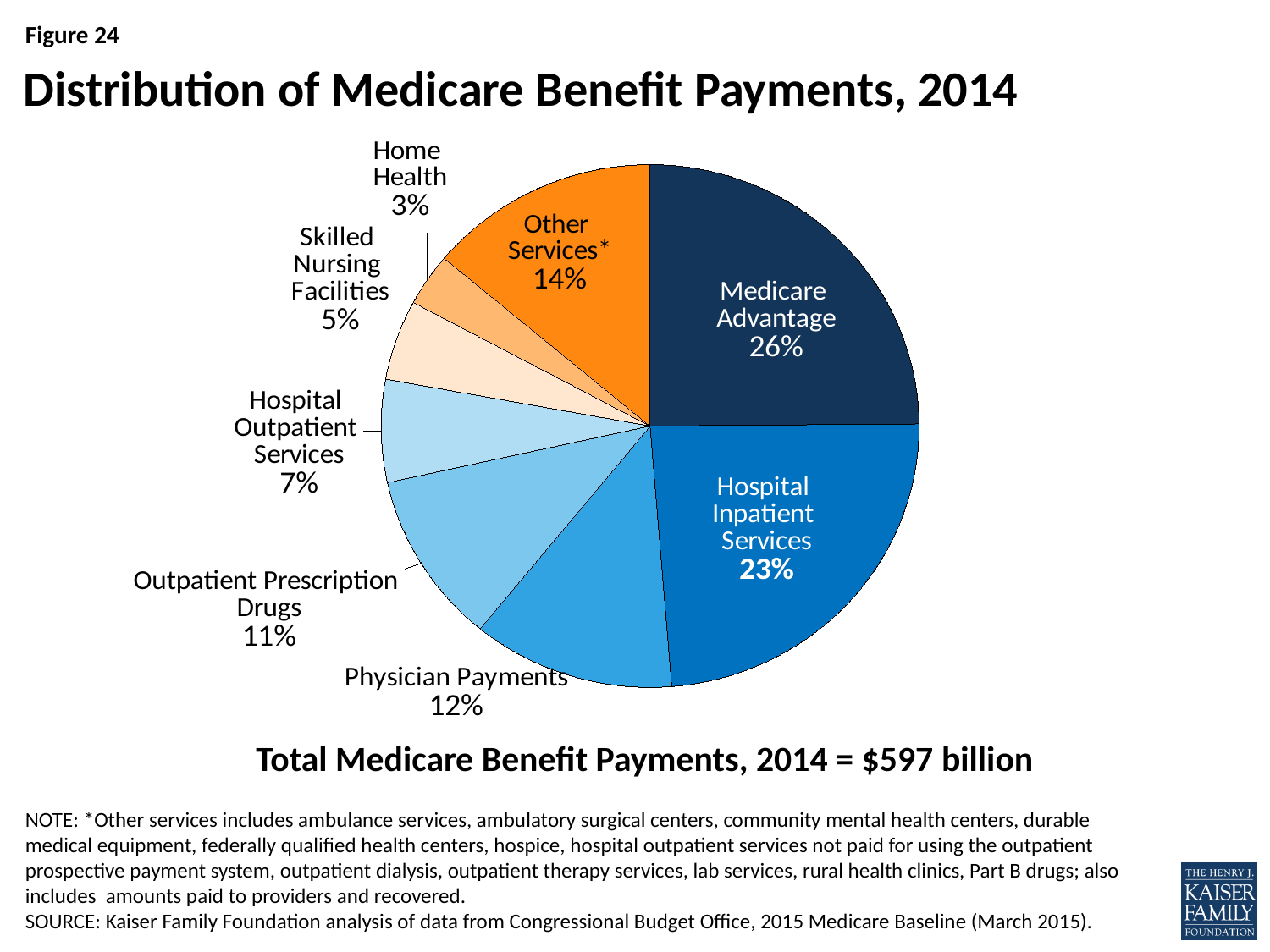
What is the combined share of Skilled Nursing Facilities and Home Health? 8% How many categories are shown in the pie chart? 8 What percentage of the pie is Hospital Inpatient Services? 23% What is the value shown for Outpatient Prescription Drugs? 11% Which category has the largest slice of the pie? Medicare Advantage What kind of chart is shown on the slide? Pie chart What is the difference in percentage points between Medicare Advantage and Hospital Inpatient Services? 3 percentage points Which category has the smallest slice of the pie? Home Health Which is larger, the share for Other Services or the share for Physician Payments? Other Services What share of Medicare benefit payments went to Medicare Advantage in 2014? 26% What is the value shown for Physician Payments? 12% What total amount of Medicare benefit payments for 2014 is stated below the chart? $597 billion